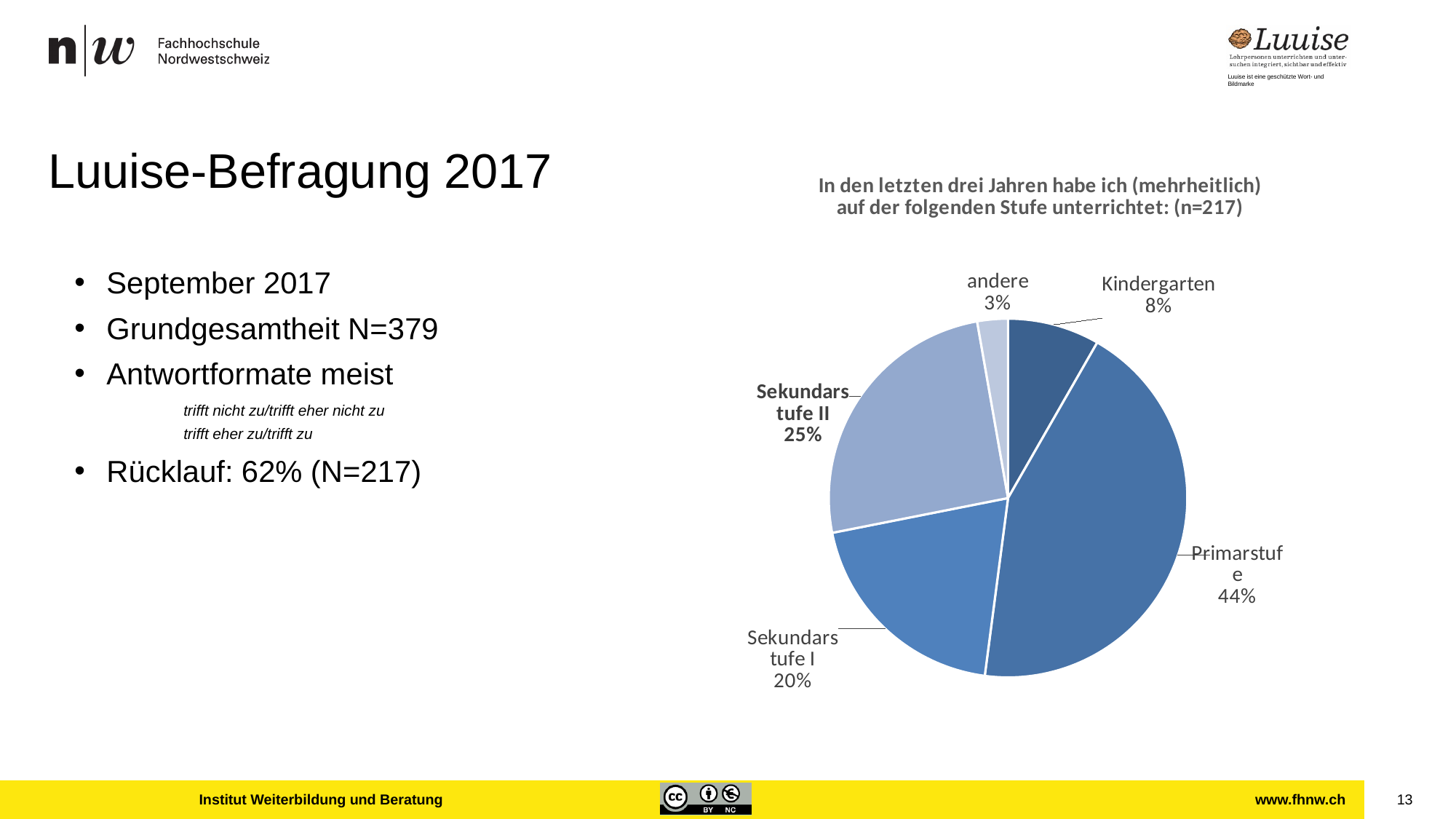
What share of the pie does Kindergarten have? 8% Which is larger, the share for Kindergarten or the share for Sekundarstufe I? Sekundarstufe I What sample size (n) is stated in the chart title? n=217 What share of the pie does Sekundarstufe II have? 25% What is the difference in percentage points between Primarstufe and Kindergarten? 36% What kind of chart is shown on the slide? pie chart Which category has the smallest slice of the pie? andere What share of the pie does Primarstufe have? 44% How many slices does the pie chart have? 5 What is the difference in percentage points between Sekundarstufe II and Sekundarstufe I? 5% Which category has the largest slice of the pie? Primarstufe